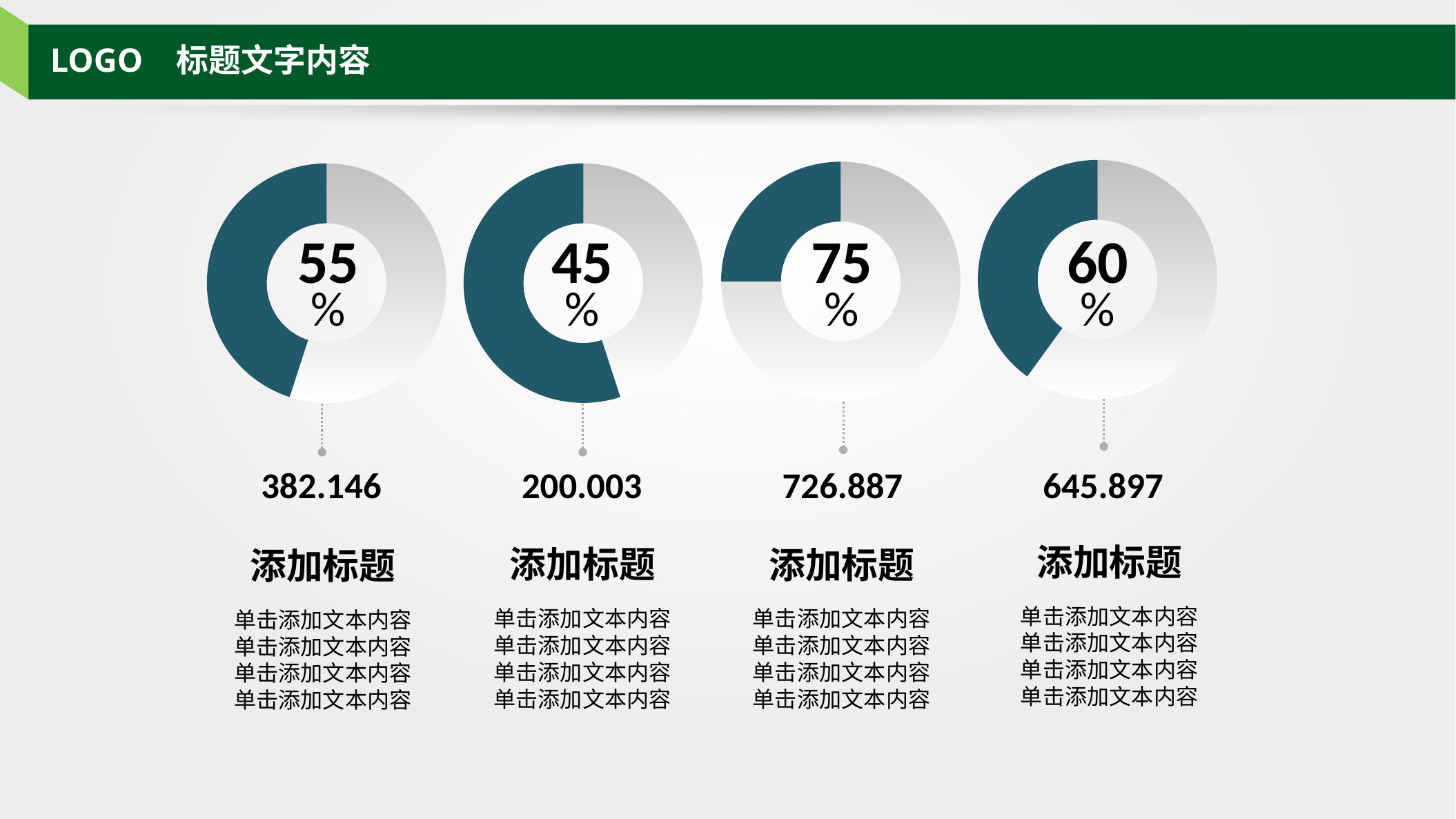
What type of chart is used for each of the four figures on the slide? donut chart Which donut chart shows the lowest percentage: the first, second, third or fourth from the left? second What percentage is shown in the centre of the third donut chart from the left? 75% How many donut charts are on the slide? 4 What is the difference between the percentage in the third donut chart and the percentage in the second donut chart? 30% What number is printed below the leftmost donut chart? 382.146 What number is printed below the third donut chart from the left? 726.887 Which is larger, the percentage in the leftmost donut chart or the percentage in the rightmost donut chart? rightmost (60%) What percentage is shown in the centre of the rightmost donut chart? 60% What percentage is shown in the centre of the second donut chart from the left? 45% Which donut chart shows the highest percentage: the first, second, third or fourth from the left? third What percentage is shown in the centre of the leftmost donut chart? 55%